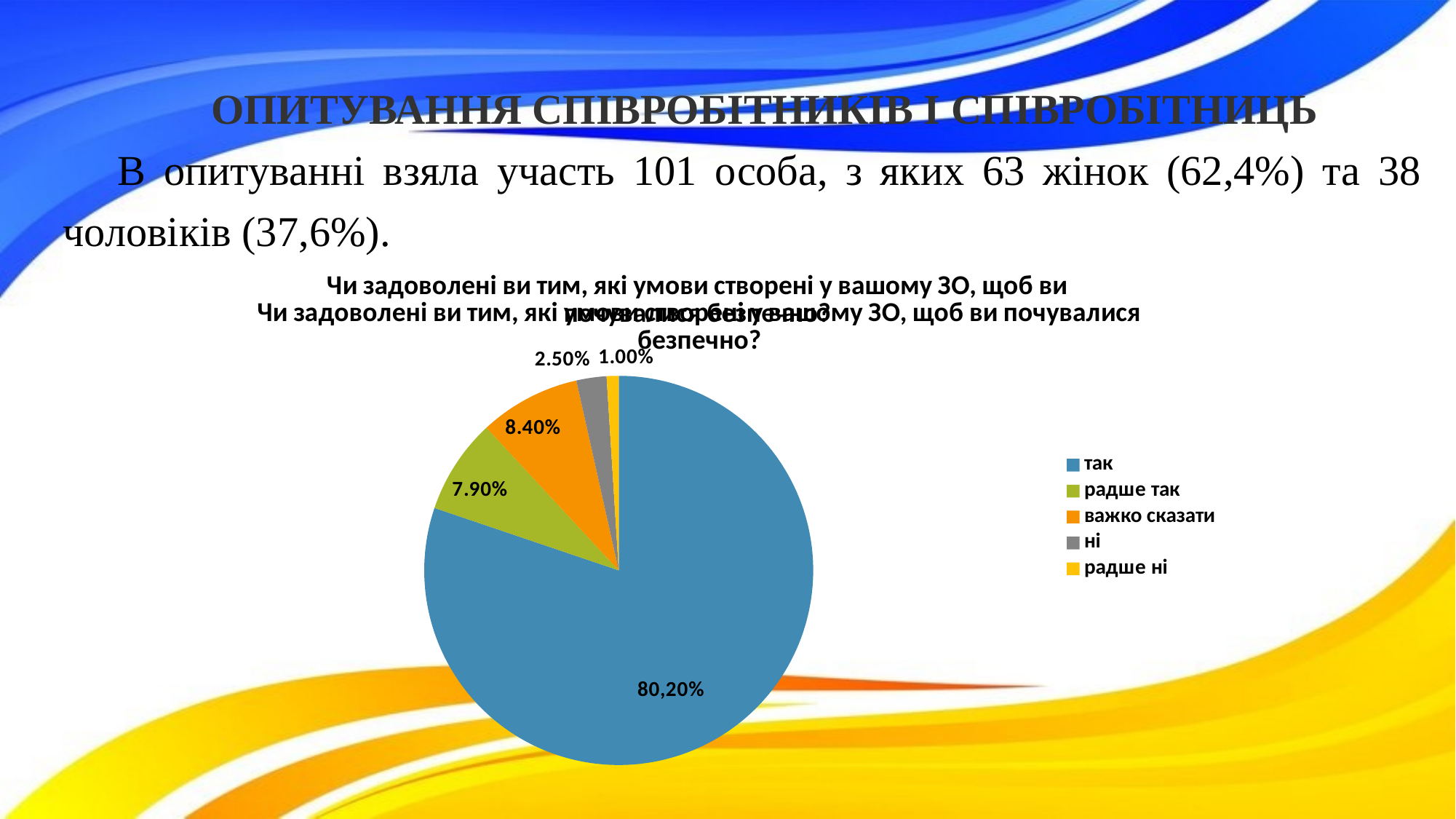
Which category has the smallest slice of the pie? радше ні What type of chart is shown on the slide? pie chart Which category has the largest slice of the pie? так What is the value shown for "ні"? 2.50% Which colour represents "ні" in the pie chart? grey What is the value shown for "важко сказати"? 8.40% What share of the pie does the "так" slice represent? 80,20% What is the value shown for "радше ні"? 1.00% Which is larger, the value for "важко сказати" or the value for "радше так"? важко сказати What is the value shown for "радше так"? 7.90% How many categories does the legend list? 5 What is the difference between the values for "важко сказати" and "радше так"? 0.50%